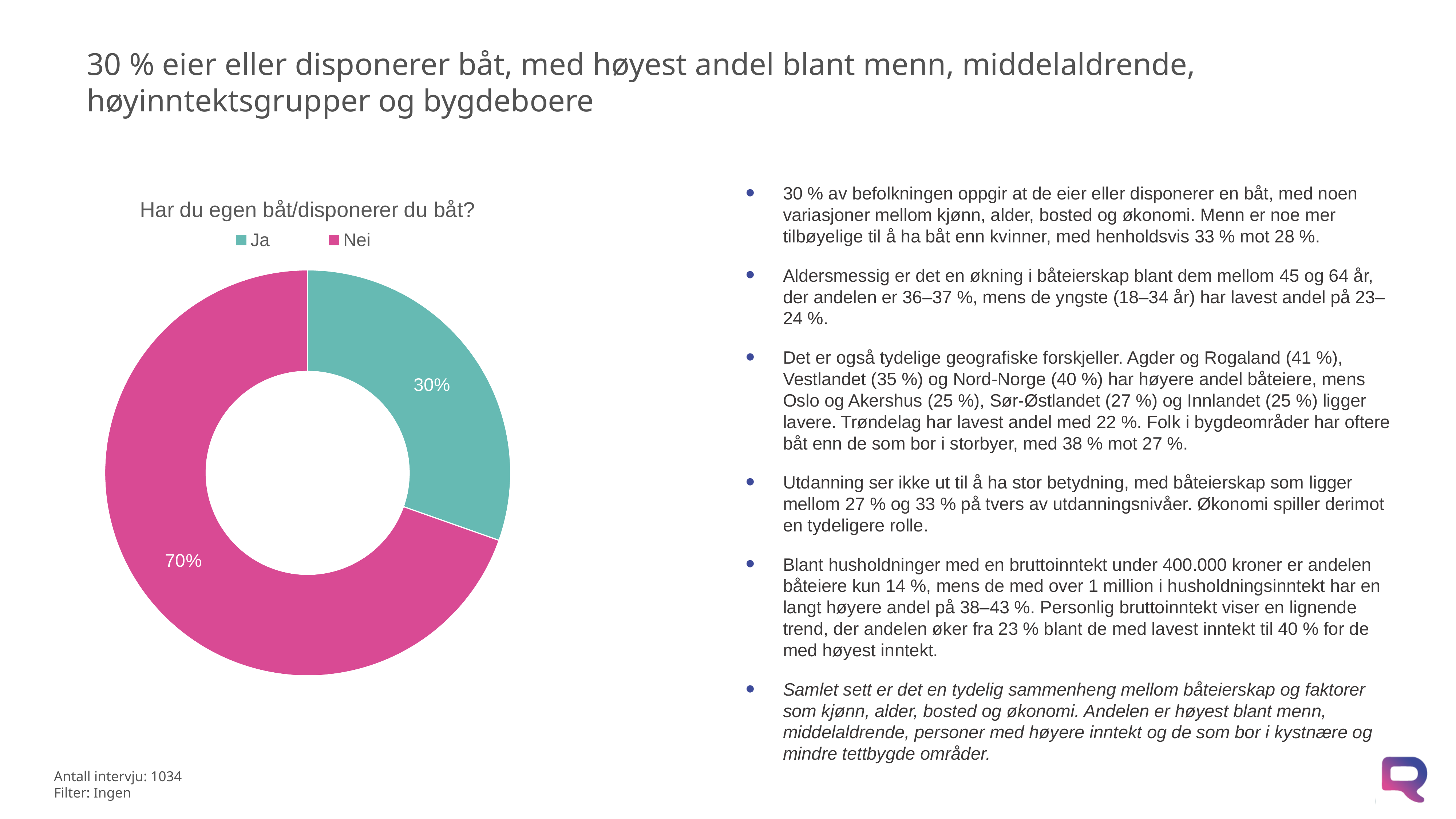
What is the title of the chart? Har du egen båt/disponerer du båt? What colour is the "Nei" slice in the chart? Pink What is the total of the two slices shown in the chart? 100% What share of the pie chart is labelled "Nei"? 70% What share of the pie chart is labelled "Ja"? 30% Which category has the smallest slice in the chart? Ja What kind of chart is shown on the slide? Pie chart (doughnut) Which is larger, the "Ja" slice or the "Nei" slice? Nei How many categories does the chart show? 2 Which category has the largest slice in the chart? Nei What is the difference in percentage points between the "Nei" and "Ja" slices? 40 How many entries does the chart legend list? 2